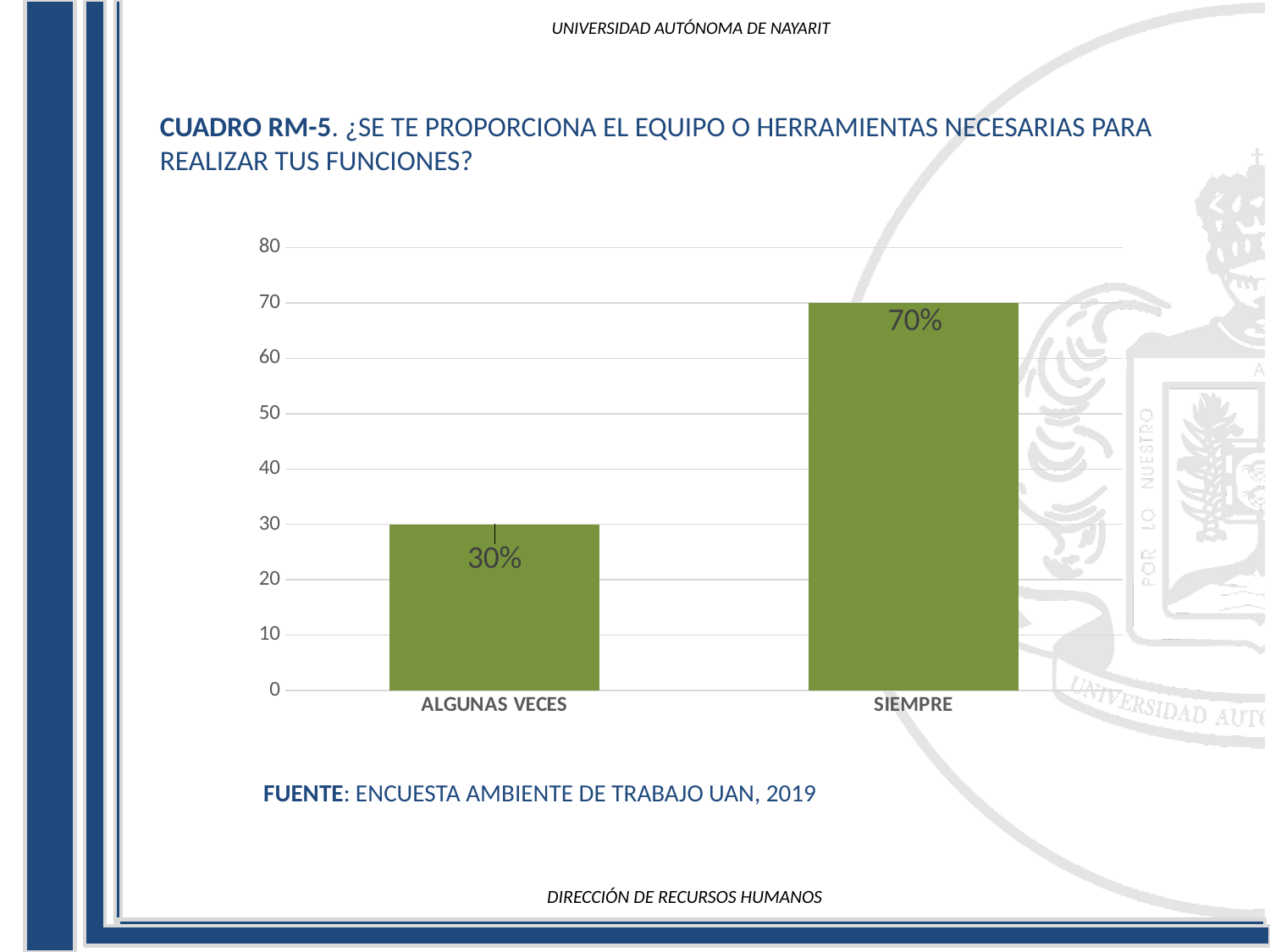
How many categories are shown on the x axis? 2 What is the difference between the values for SIEMPRE and ALGUNAS VECES? 40% Which category has the lowest value? ALGUNAS VECES What is the total of the two values shown in the chart? 100% What is the value for SIEMPRE? 70% What kind of chart is shown on the slide? bar chart Which category has the highest value? SIEMPRE What source is cited below the chart? ENCUESTA AMBIENTE DE TRABAJO UAN, 2019 Is the value for ALGUNAS VECES greater or less than 40? less What is the value for ALGUNAS VECES? 30% Which is larger, the value for ALGUNAS VECES or the value for SIEMPRE? SIEMPRE Is the value for SIEMPRE greater or less than 50? greater